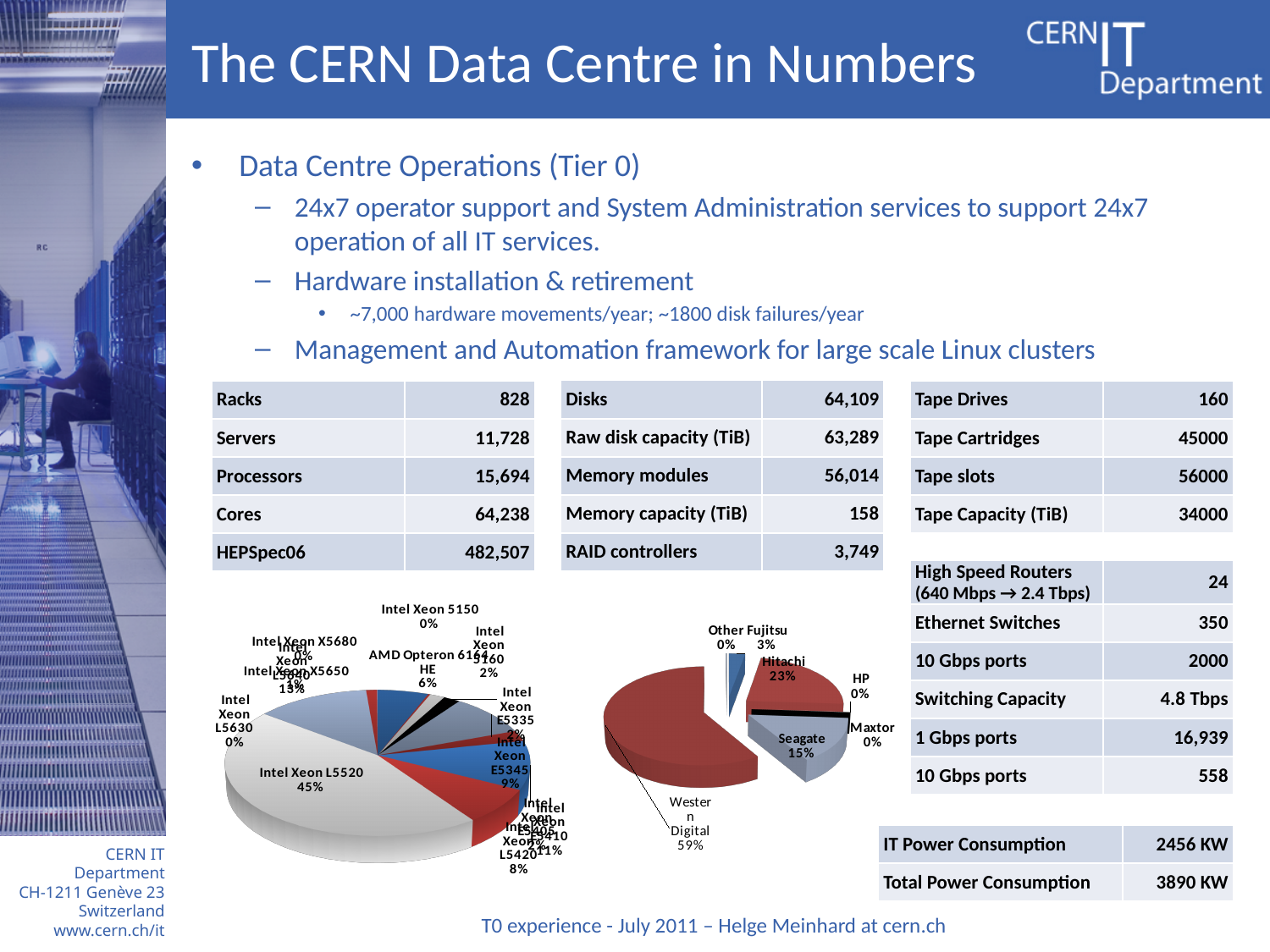
In the right pie chart, what share does Fujitsu have? 3% In the right pie chart, what is the difference between the Hitachi and Seagate shares? 8% In the right pie chart, what share does Western Digital have? 59% In the right pie chart, what share does Seagate have? 15% In the right pie chart, how many slices are labelled? 7 In the left pie chart, which is larger, Intel Xeon E5345 or Intel Xeon L5420? Intel Xeon E5345 In the right pie chart, what share does Hitachi have? 23% What type of chart is the chart on the left of the slide? pie chart In the left pie chart, what share does Intel Xeon L5520 have? 45% In the right pie chart, which slice is the largest? Western Digital In the left pie chart, what share does Intel Xeon X5650 have? 1%